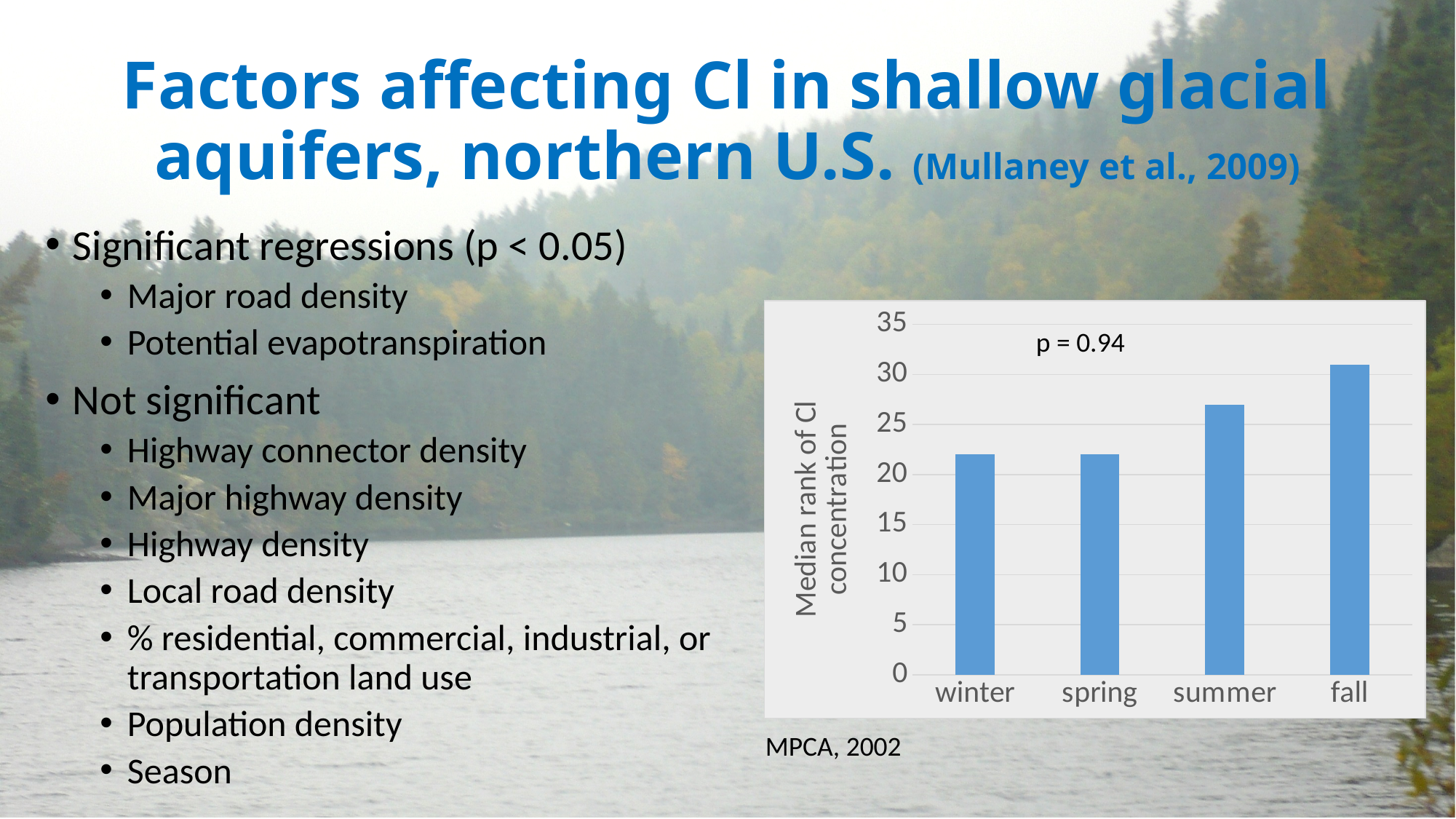
Is the value for winter greater or less than 20? greater Which is larger, the value for summer or the value for spring? summer Which season has the highest median rank of Cl concentration? fall Is the value for fall greater or less than 25? greater What kind of chart is shown on the slide? bar chart Which is larger, the value for fall or the value for winter? fall What p value is annotated on the chart? p = 0.94 How many seasons are plotted on the x axis of the chart? 4 Is the value for spring greater or less than 25? less What is the label on the y axis of the chart? Median rank of Cl concentration Do the values generally rise or fall from winter to fall along the x axis? rise